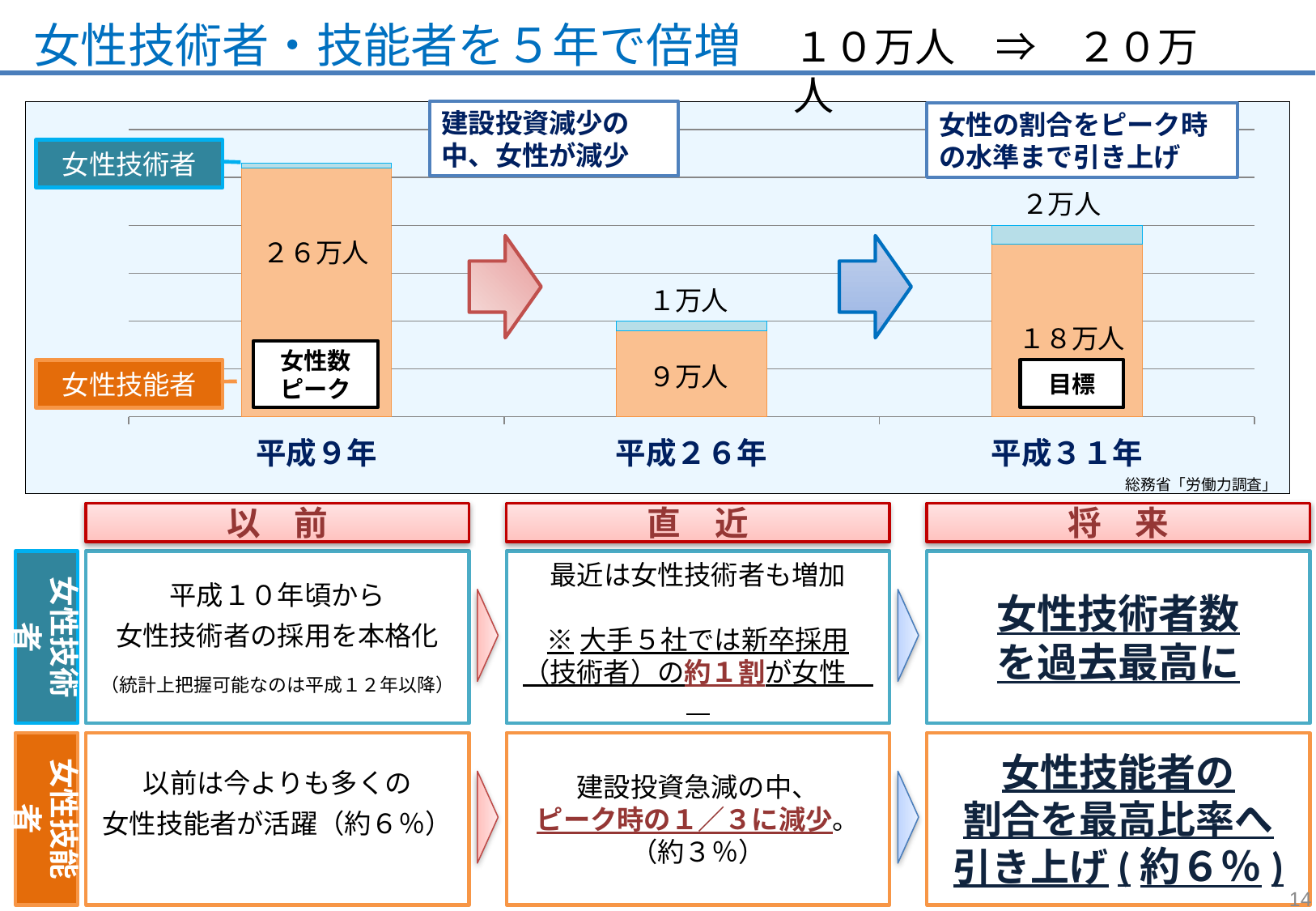
What is the value for 女性技術者 in 平成31年? 2万人 What is the value for 女性技術者 in 平成26年? 1万人 Which year has the highest value for 女性技能者? 平成9年 What is the difference between the 女性技能者 values for 平成9年 and 平成26年? 17万人 What kind of chart is shown on the slide? stacked bar chart How many categories (years) are shown on the x axis of the chart? 3 What is the total of the stacked bar for 平成31年? 20万人 How many series does the chart show? 2 What is the value for 女性技能者 in 平成26年? 9万人 What is the value for 女性技能者 in 平成9年? 26万人 Which year has the lowest value for 女性技能者? 平成26年 What is the value for 女性技能者 in 平成31年? 18万人